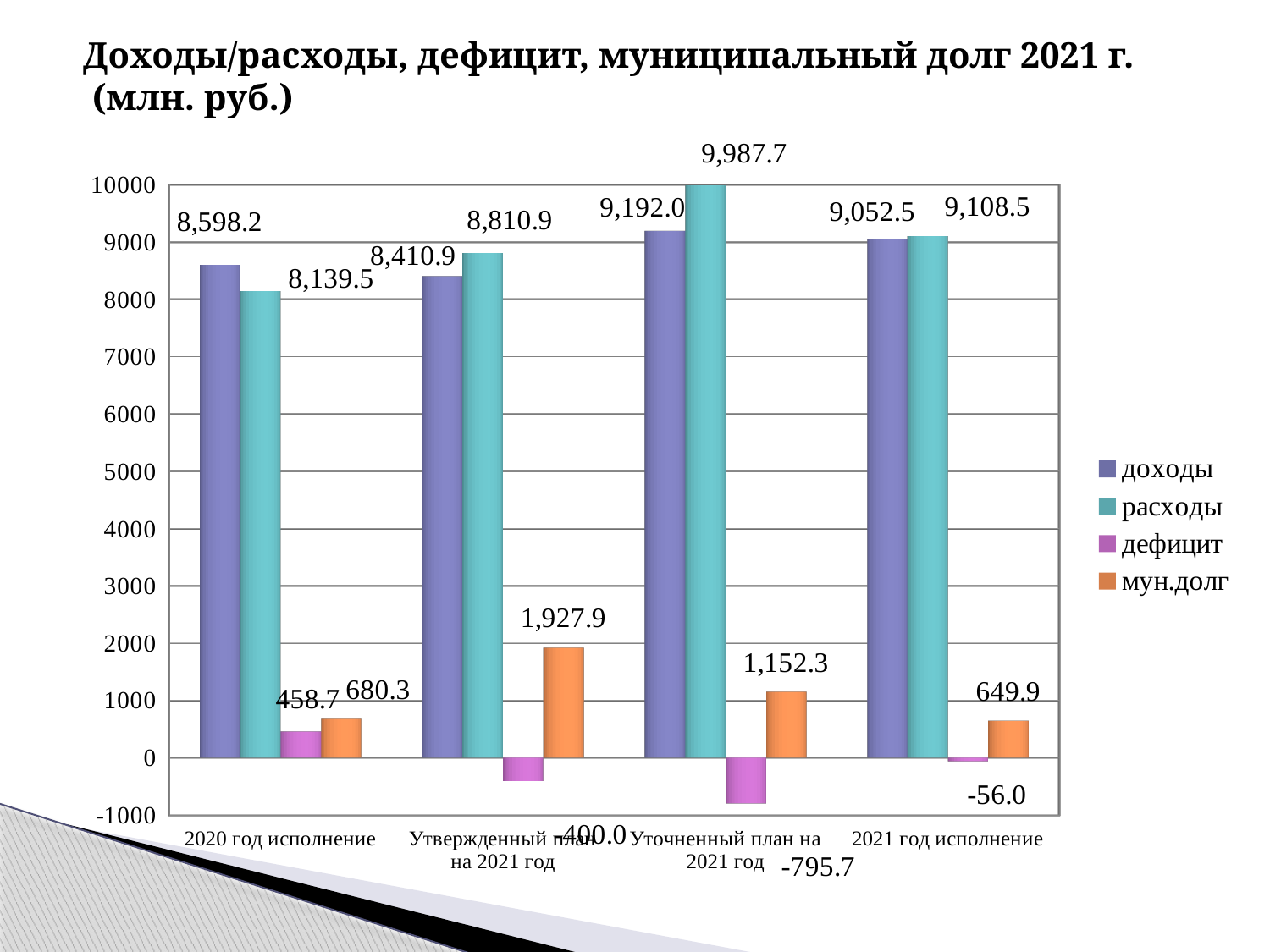
What is the value of мун.долг for Утвержденный план на 2021 год? 1,927.9 What is the difference between расходы and доходы for 2021 год исполнение? 56.0 How many categories are shown on the x axis? 4 For 2020 год исполнение, which is larger: доходы or расходы? доходы What is the value of дефицит for 2021 год исполнение? -56.0 What is the difference between мун.долг for Утвержденный план на 2021 год and Уточненный план на 2021 год? 775.6 Which category has the lowest value for мун.долг? 2021 год исполнение Which category has the highest value for расходы? Уточненный план на 2021 год How many series does the legend list? 4 Is the value of мун.долг for Уточненный план на 2021 год greater or less than 1000? greater What is the value of доходы for 2020 год исполнение? 8,598.2 What is the value of расходы for Уточненный план на 2021 год? 9,987.7